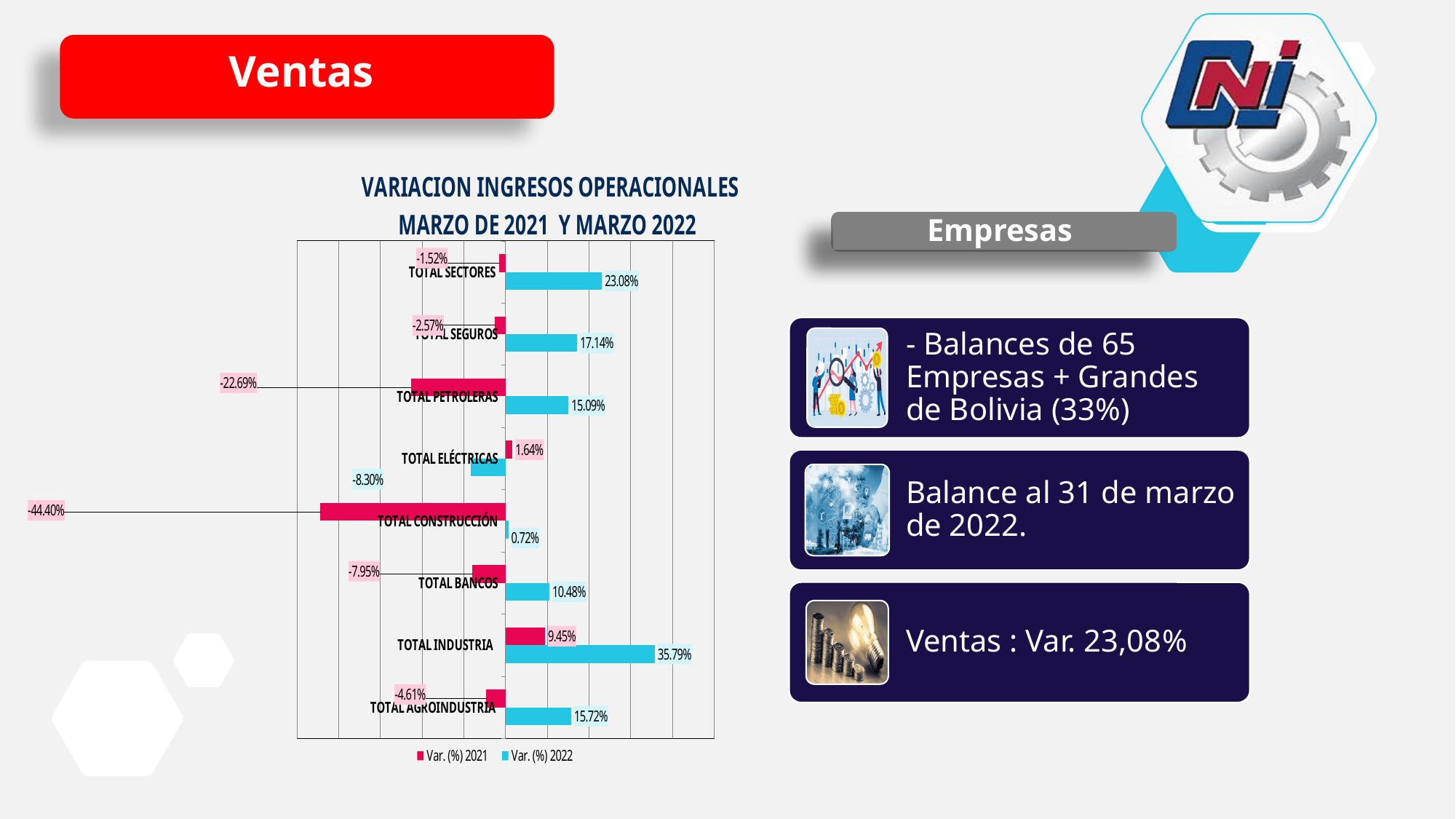
How many categories are shown in the chart? 8 What is the Var. (%) 2022 value for TOTAL ELÉCTRICAS? -8.30% How many series does the chart legend list? 2 What is the Var. (%) 2021 value for TOTAL INDUSTRIA? 9.45% What is the difference between the Var. (%) 2022 values for TOTAL INDUSTRIA and TOTAL SECTORES? 12.71% Which category has the lowest Var. (%) 2021 value? TOTAL CONSTRUCCIÓN What is the title of the chart? VARIACION INGRESOS OPERACIONALES MARZO DE 2021 Y MARZO 2022 What is the Var. (%) 2021 value for TOTAL CONSTRUCCIÓN? -44.40% Which category has the highest Var. (%) 2022 value? TOTAL INDUSTRIA What is the Var. (%) 2022 value for TOTAL SECTORES? 23.08% Which is larger, the Var. (%) 2022 value for TOTAL SEGUROS or for TOTAL BANCOS? TOTAL SEGUROS What kind of chart is shown on the slide? Bar chart